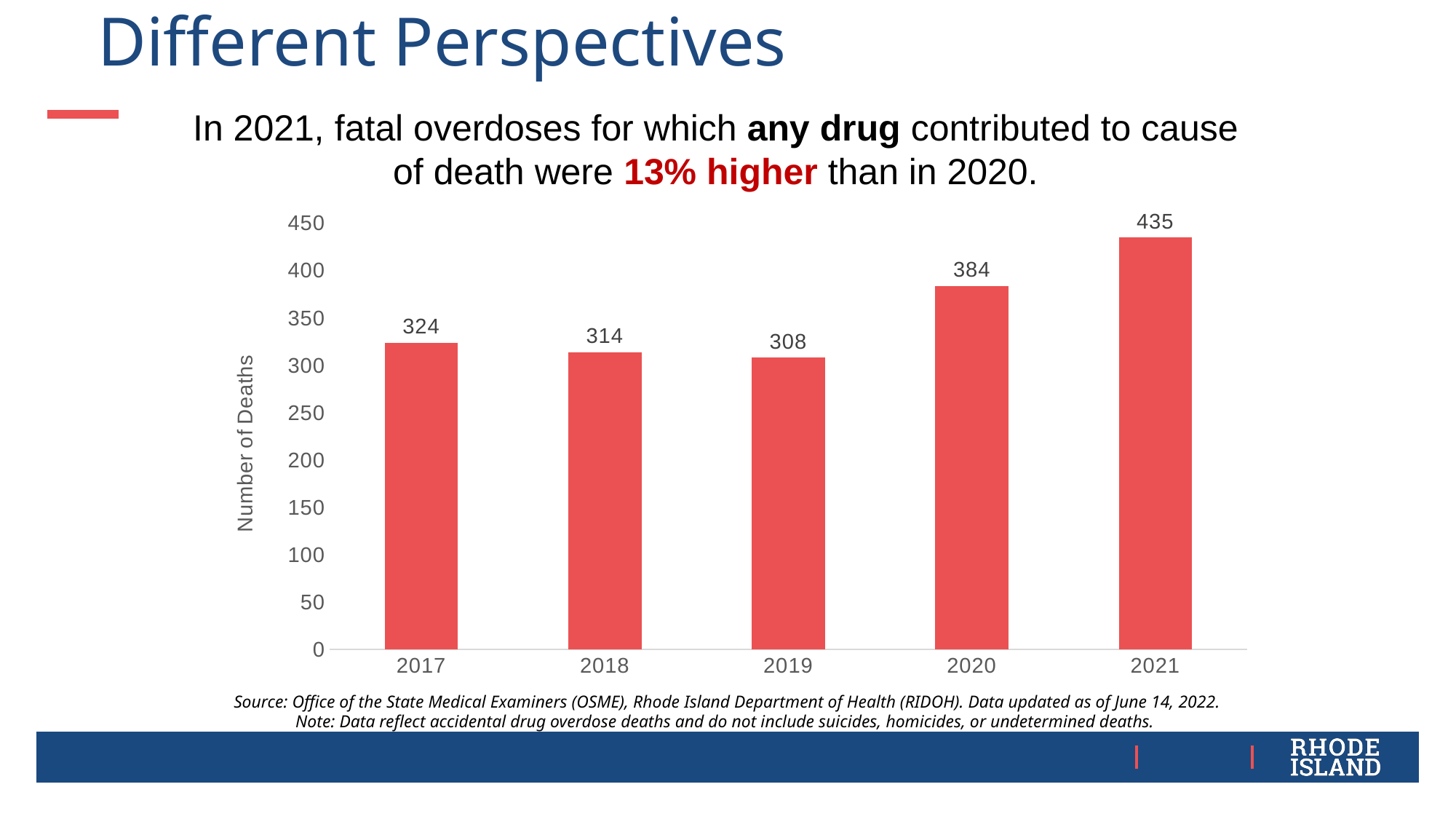
Which year has the highest number of deaths? 2021 Is the value for 2020 greater or less than 350? greater What is the number of deaths shown for 2017? 324 What is the difference in number of deaths between 2021 and 2020? 51 What is the difference in number of deaths between 2017 and 2018? 10 How many years are shown on the x axis? 5 What is the number of deaths shown for 2019? 308 What kind of chart is shown on the slide? Bar chart What is the label of the y axis? Number of Deaths What is the number of deaths shown for 2021? 435 Which year has the lowest number of deaths? 2019 Which year has more deaths, 2018 or 2020? 2020